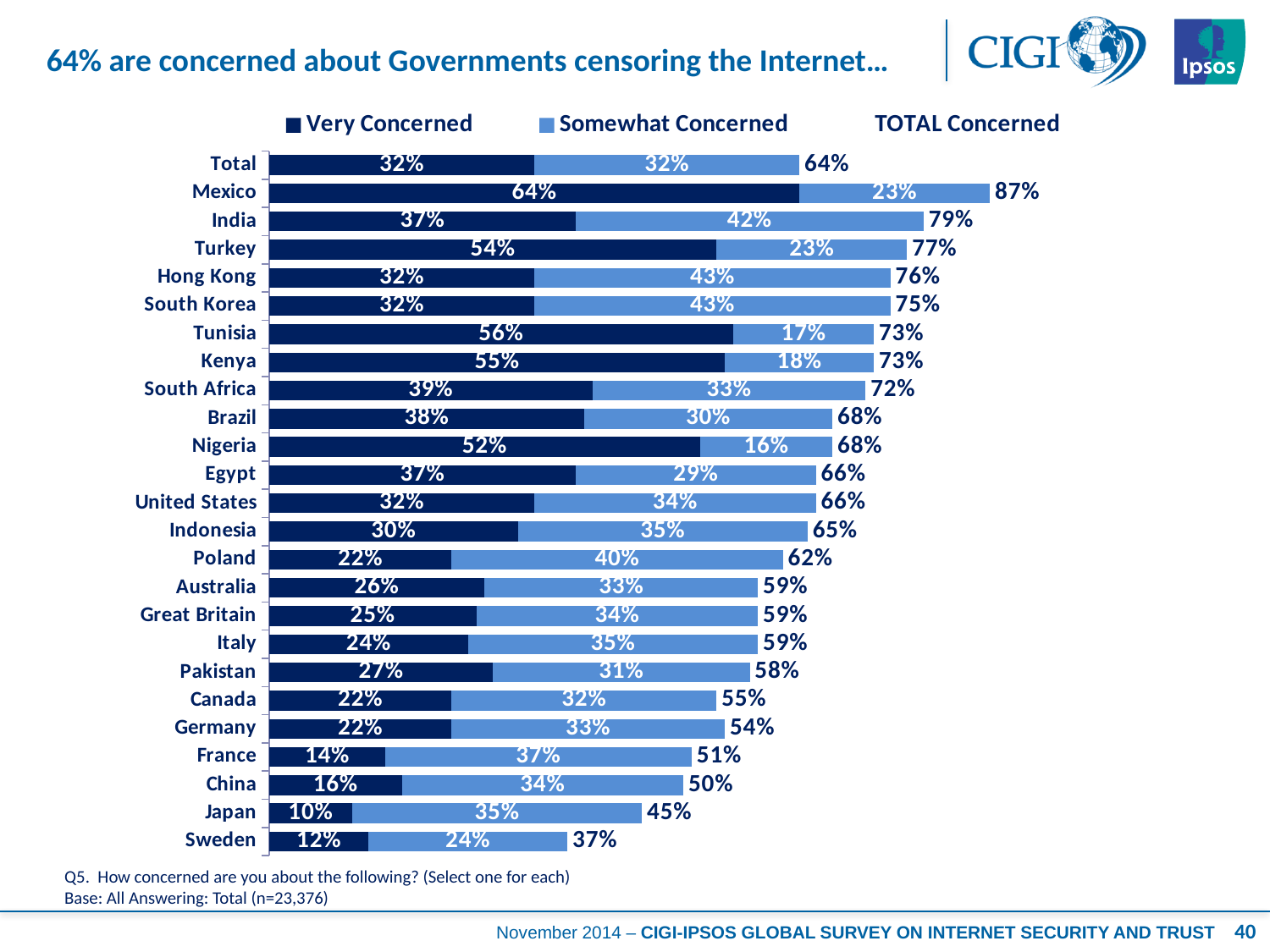
Which country has the highest Very Concerned percentage? Mexico What is the Somewhat Concerned value for Poland? 40% How many series are shown with colour markers in the legend? 2 What is the difference in TOTAL Concerned between Mexico and Sweden? 50 percentage points How many categories (including Total) are plotted on the chart? 25 What is the TOTAL Concerned value shown for Germany? 54% Which country has the lowest TOTAL Concerned percentage? Sweden What type of chart is shown on the slide? Stacked bar chart Which has a larger Somewhat Concerned value, India or Turkey? India Which country has the lowest Very Concerned percentage? Japan What percentage of respondents in Kenya are Very Concerned about governments censoring the Internet? 55% What is the combined total of the Very Concerned and Somewhat Concerned segments for India? 79%